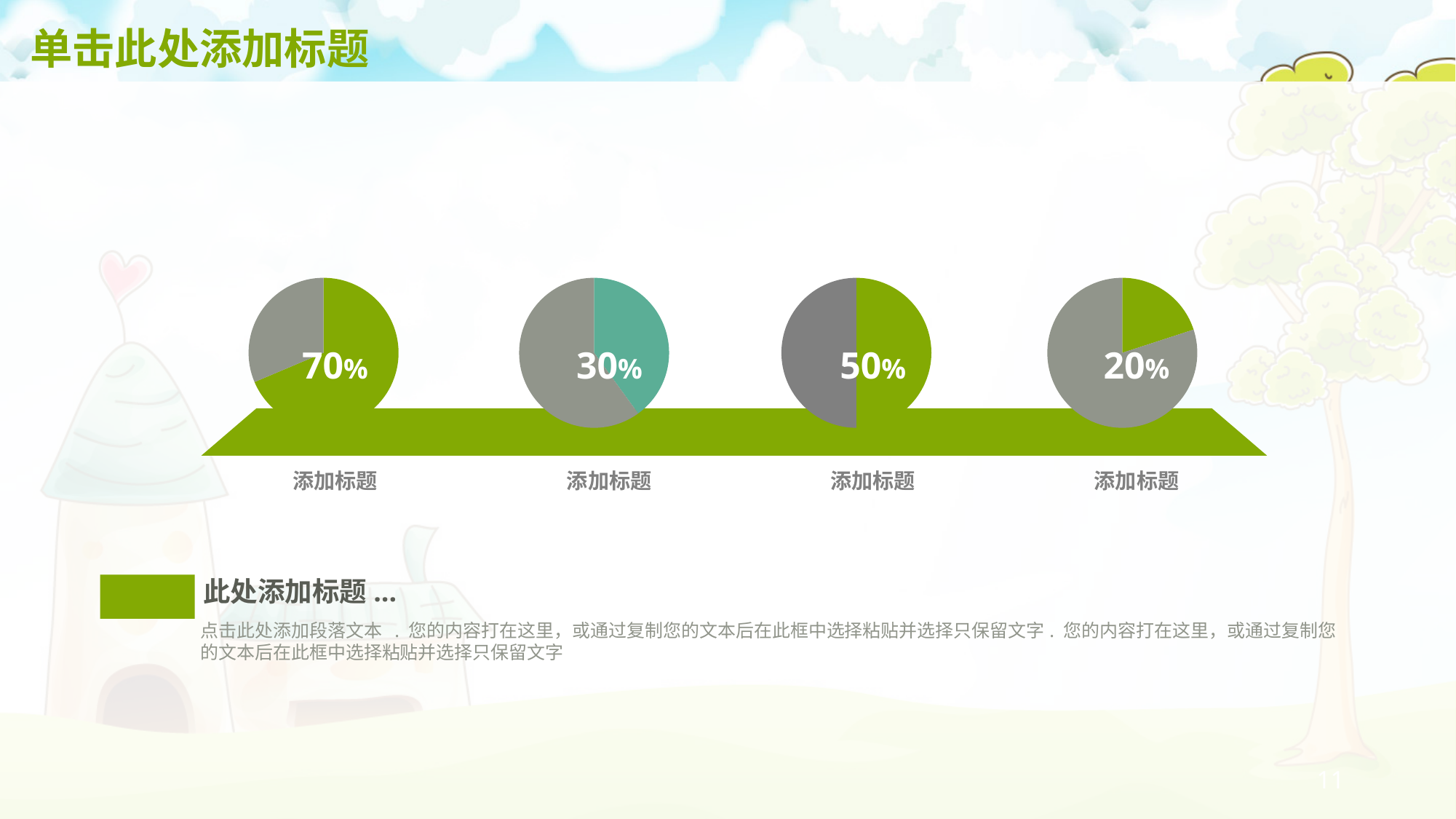
Which pie chart shows the highest percentage? The leftmost pie chart (70%) What percentage is printed on the rightmost pie chart? 20% Which pie chart shows the lowest percentage? The rightmost pie chart (20%) Which is larger: the percentage on the second pie chart from the left or the percentage on the third pie chart from the left? The third pie chart (50%) What kind of charts are shown in the row across the middle of the slide? Pie charts What percentage is printed on the leftmost pie chart? 70% Which pie chart uses a teal colour for its highlighted slice instead of green? The second pie chart from the left (30%) What is the difference between the percentage on the leftmost pie chart and the percentage on the rightmost pie chart? 50% Do the percentages on the pie charts consistently decrease from left to right? No How many pie charts are shown on the slide? 4 What percentage is printed on the third pie chart from the left? 50% What percentage is printed on the second pie chart from the left? 30%